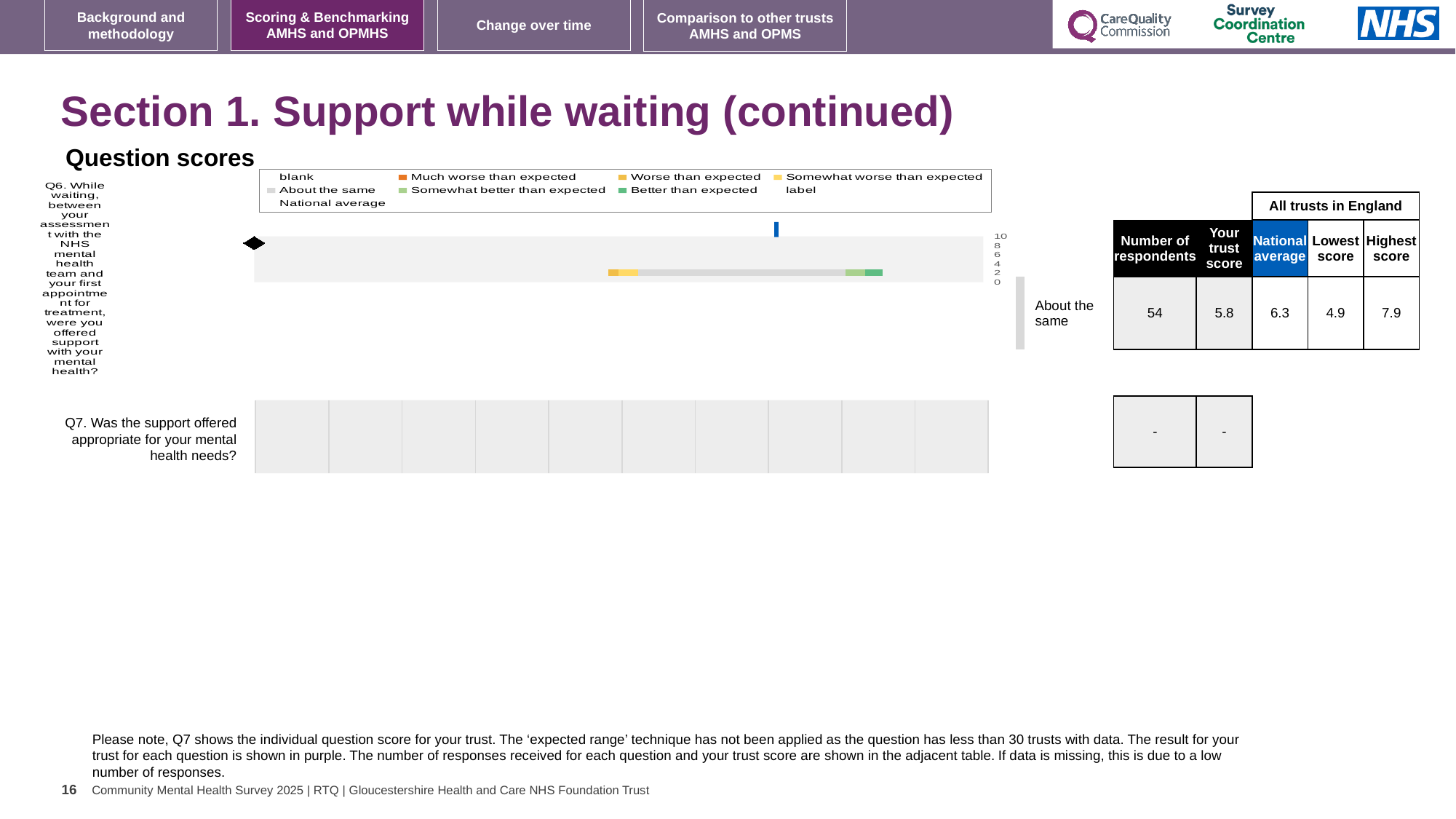
Which legend entry in the Question scores chart is shown in orange? Much worse than expected What kind of chart is used to show the Q6 question score? bar chart What is the highest score for Q6 in the table beside the Question scores chart? 7.9 What is the trust score for Q6 in the table beside the Question scores chart? 5.8 How many respondents answered Q6 according to the table beside the Question scores chart? 54 What category label is given for Q6 next to the Question scores chart? About the same What is the lowest score for Q6 in the table beside the Question scores chart? 4.9 What is the maximum value shown on the axis of the Question scores chart? 10 Which is larger for Q6, the trust score or the national average? national average Which legend entry in the Question scores chart is shown in grey? About the same What is the national average for Q6 in the table beside the Question scores chart? 6.3